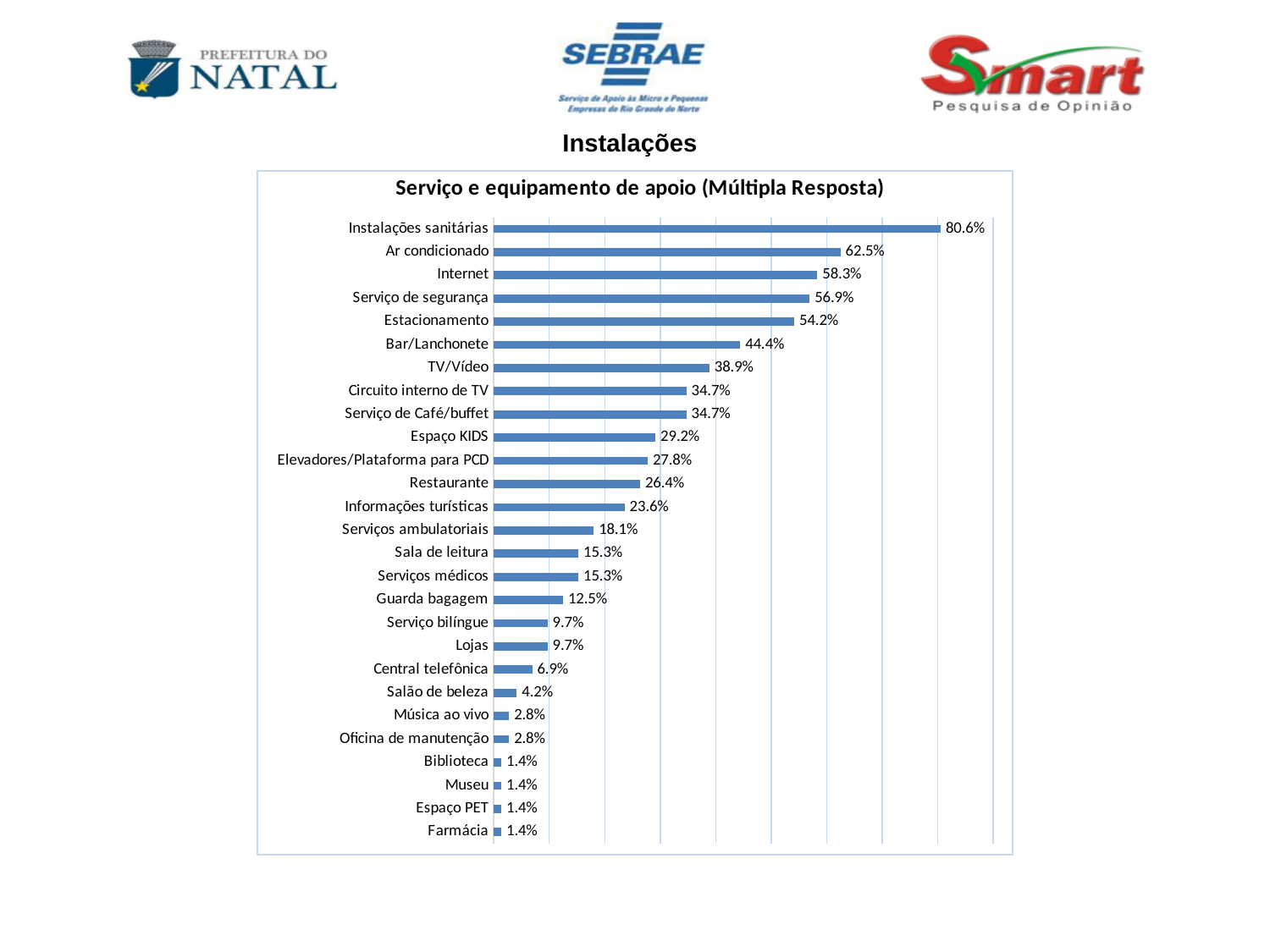
What is the value for Serviços ambulatoriais? 18.1% Which is larger, the value for Central telefônica or the value for Salão de beleza? Central telefônica What is the title of the chart? Serviço e equipamento de apoio (Múltipla Resposta) How many categories are shown in the chart? 27 What is the value for Instalações sanitárias? 80.6% What is the difference between the values for Bar/Lanchonete and TV/Vídeo? 5.5% Which is larger, the value for Espaço KIDS or the value for Restaurante? Espaço KIDS Which category has the highest value? Instalações sanitárias What is the value for Estacionamento? 54.2% What is the difference between the values for Ar condicionado and Internet? 4.2% What kind of chart is shown on the slide? Bar chart What is the value for Guarda bagagem? 12.5%